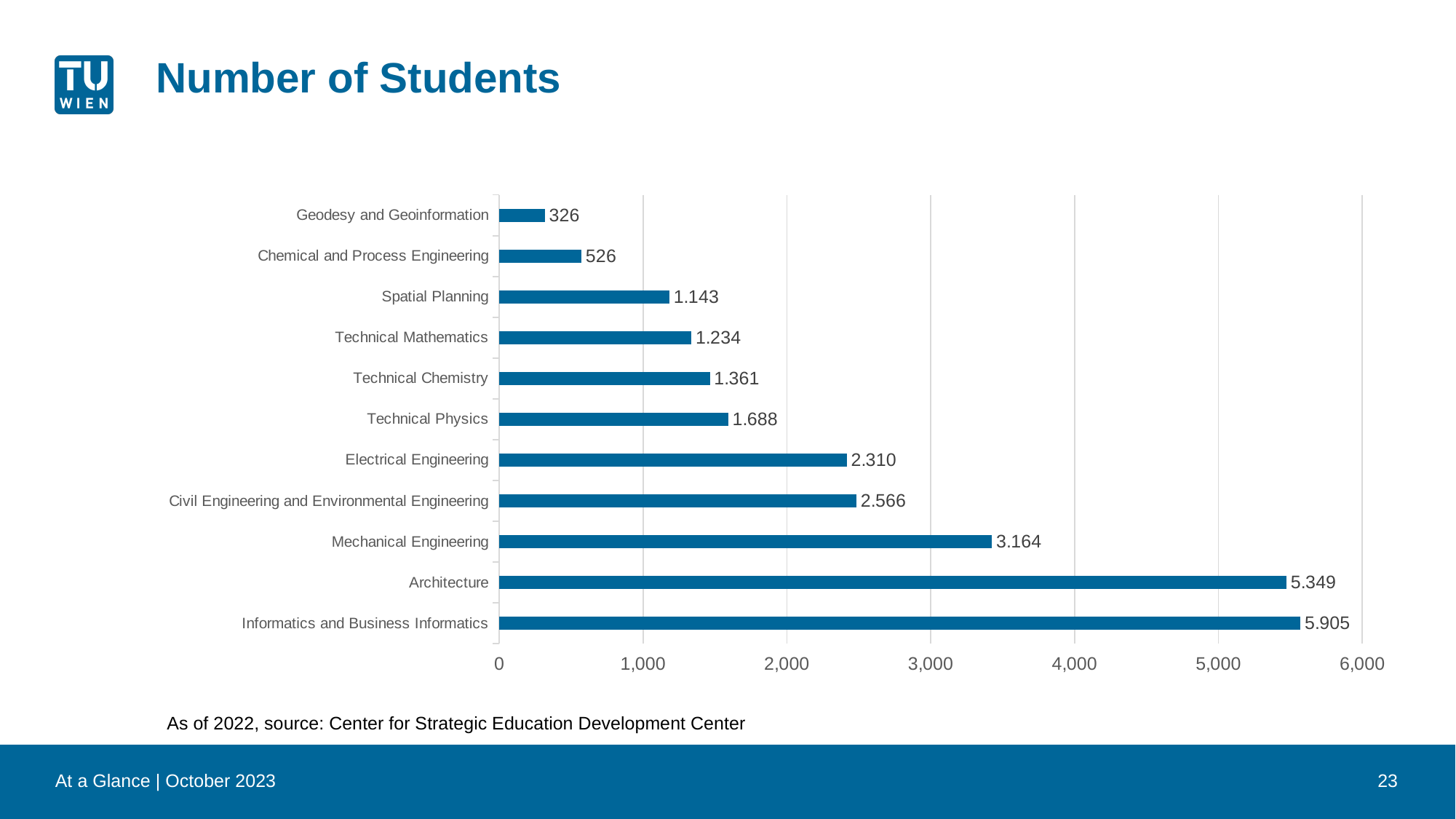
Which has more students, Mechanical Engineering or Civil Engineering and Environmental Engineering? Mechanical Engineering How many study programmes are shown in the chart? 11 What is the number of students for Chemical and Process Engineering? 526 What kind of chart is shown on the slide? bar chart What is the difference between Informatics and Business Informatics and Architecture? 556 How many students are shown for Architecture? 5.349 What is the title of the slide? Number of Students Which study programme has the highest number of students? Informatics and Business Informatics What is the difference between Technical Physics and Technical Chemistry? 327 Which study programme has the lowest number of students? Geodesy and Geoinformation What is the value for Technical Physics? 1.688 Is the value for Mechanical Engineering greater or less than 3,000? greater